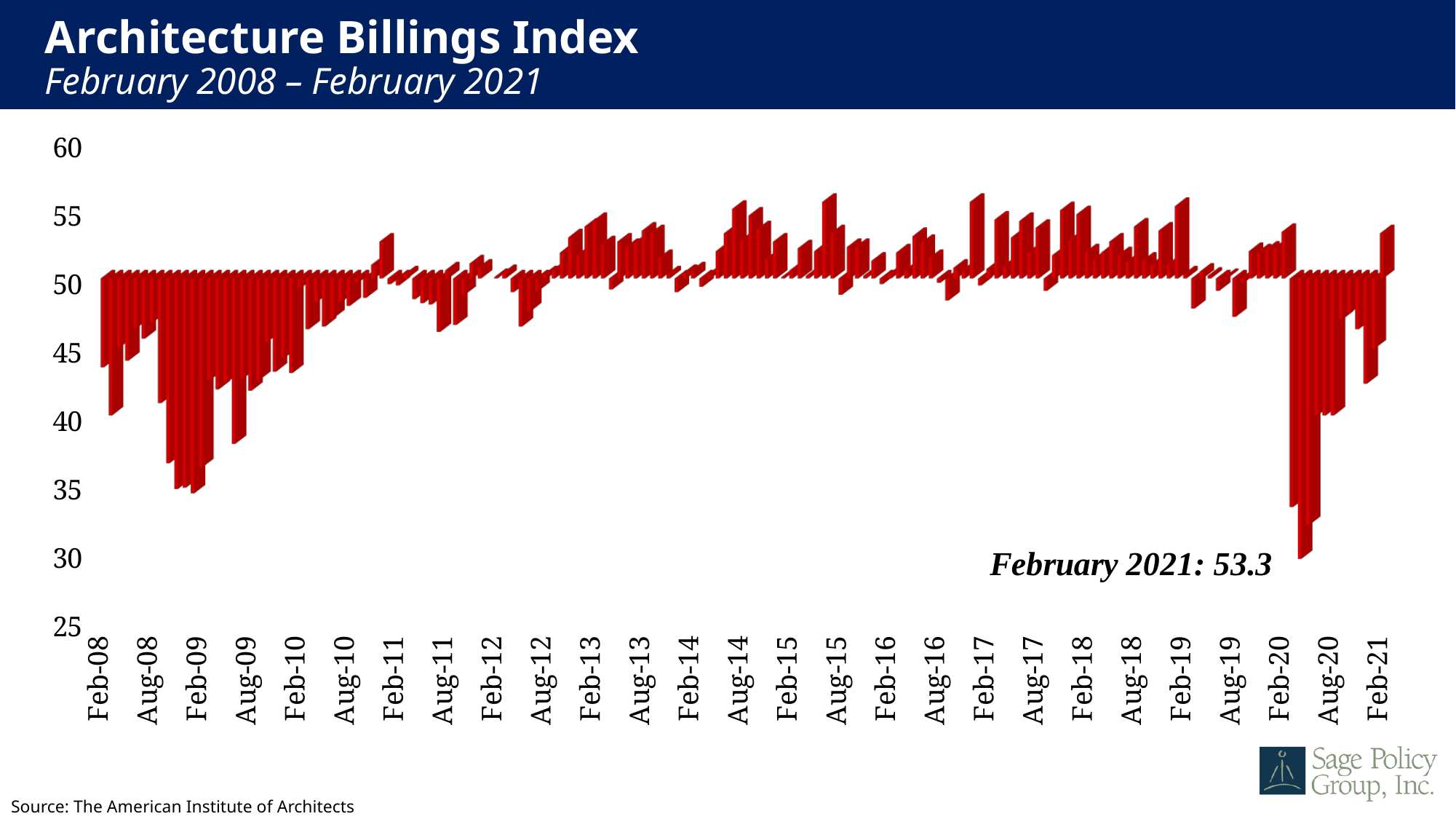
What is the value of the Architecture Billings Index for February 2021? 53.3 Is the value for Feb-21 greater or less than 50? greater What is the title of the chart? Architecture Billings Index Is the value for Feb-09 greater or less than 40? less Is the lowest value shown on the chart greater or less than 35? less Which is larger, the value for Feb-09 or the value for Feb-13? Feb-13 What kind of chart is shown on the slide? bar chart In which year does the chart reach its lowest value? 2020 Do the values rise or fall from Aug-20 to Feb-21? rise Do the values rise or fall from Feb-08 to Feb-09? fall What is the source of the data shown on the slide? The American Institute of Architects